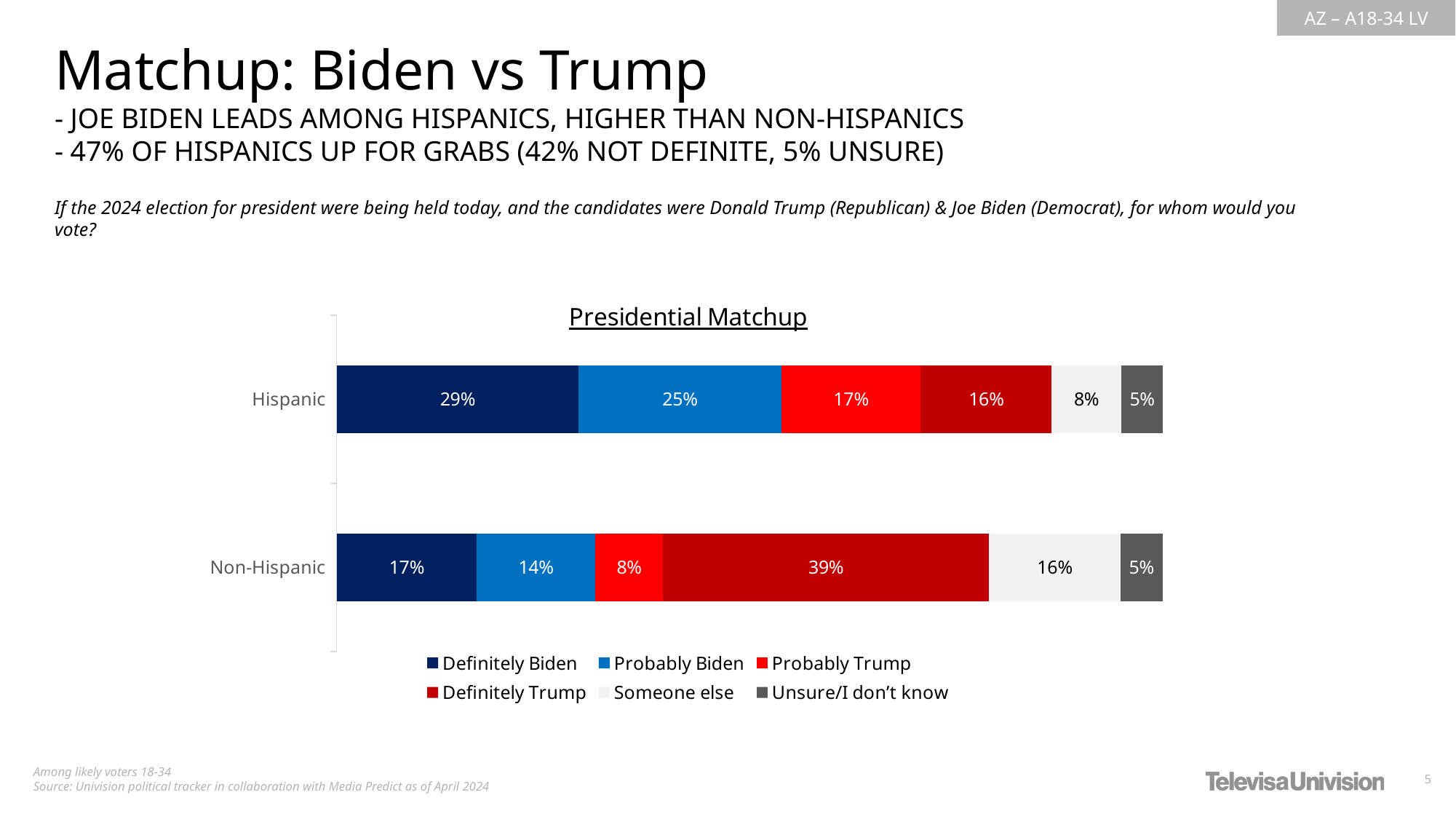
What is the difference between the Definitely Trump share for Non-Hispanic and Hispanic respondents? 23 percentage points Which series has the largest segment in the Non-Hispanic bar? Definitely Trump What percentage of Non-Hispanic respondents said Someone else? 16% What kind of chart is shown on the slide? Stacked bar chart How many categories are shown on the chart? 2 Which category has the higher Definitely Biden share, Hispanic or Non-Hispanic? Hispanic What is the difference between the Probably Biden share for Hispanic and Non-Hispanic respondents? 11 percentage points Which series has the smallest segment in the Hispanic bar? Unsure/I don't know What percentage of Hispanic respondents said Probably Trump? 17% What percentage of Non-Hispanic respondents said Definitely Trump? 39% How many series does the legend list? 6 What percentage of Hispanic respondents said Definitely Biden? 29%